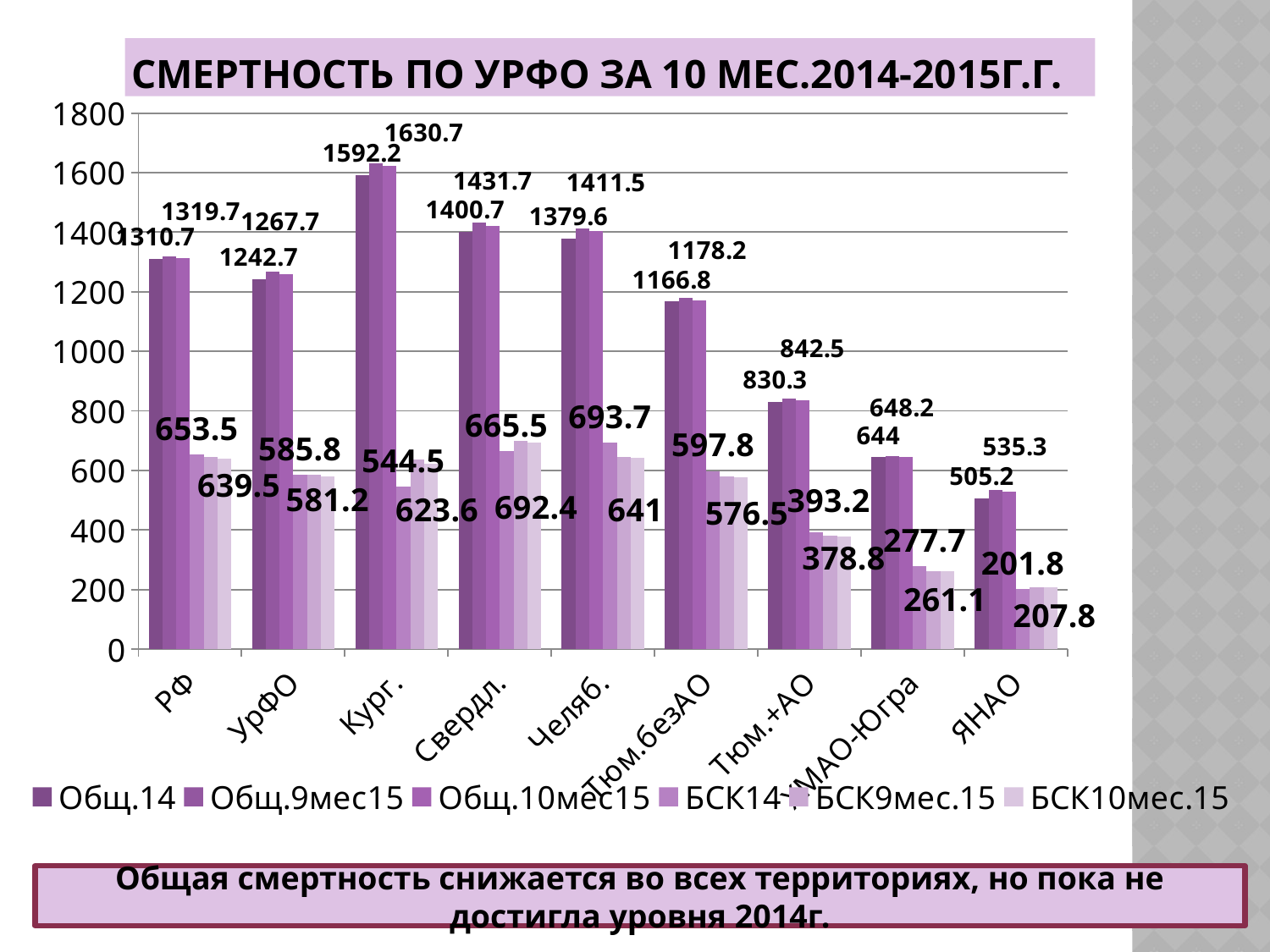
Which has the larger Общ.14 value, Кург. or Свердл.? Кург. How many categories are shown on the x axis of the chart? 9 What is the largest data label shown for Кург.? 1630.7 Is the value for Общ.14 for ЯНАО greater or less than 600? less Which category has the shortest bars in the chart? ЯНАО What kind of chart is shown on the slide? bar chart Is the value for Общ.14 for Кург. greater or less than 1400? greater What is the smallest data label shown for ЯНАО? 201.8 How many series does the chart legend list? 6 What is the largest data label shown for РФ? 1319.7 What is the title of the chart? СМЕРТНОСТЬ ПО УРФО ЗА 10 МЕС.2014-2015Г.Г. Which category has the tallest bars in the chart? Кург.